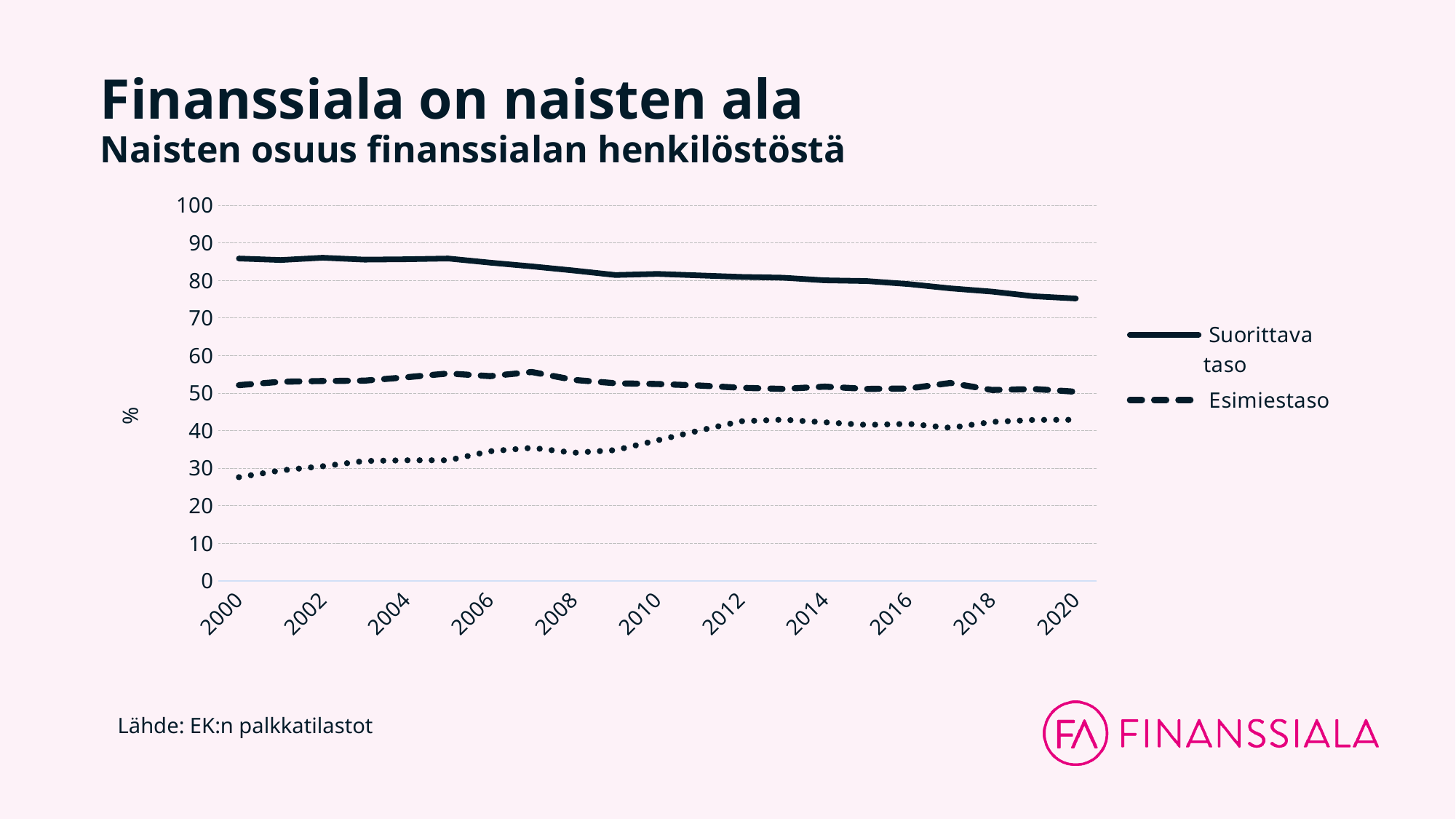
What is the label on the y axis? % In 2020, which is larger: Suorittava taso or Esimiestaso? Suorittava taso Is the value for Suorittava taso in 2000 greater or less than 80? greater How many year labels are shown on the x axis? 11 Is the value for Suorittava taso in 2020 greater or less than 70? greater Is the value for Suorittava taso in 2020 greater or less than 80? less Which series does the solid line represent? Suorittava taso Does the Suorittava taso line rise or fall from 2000 to 2020? fall How many series does the legend list? 2 What kind of chart is shown on the slide? line chart